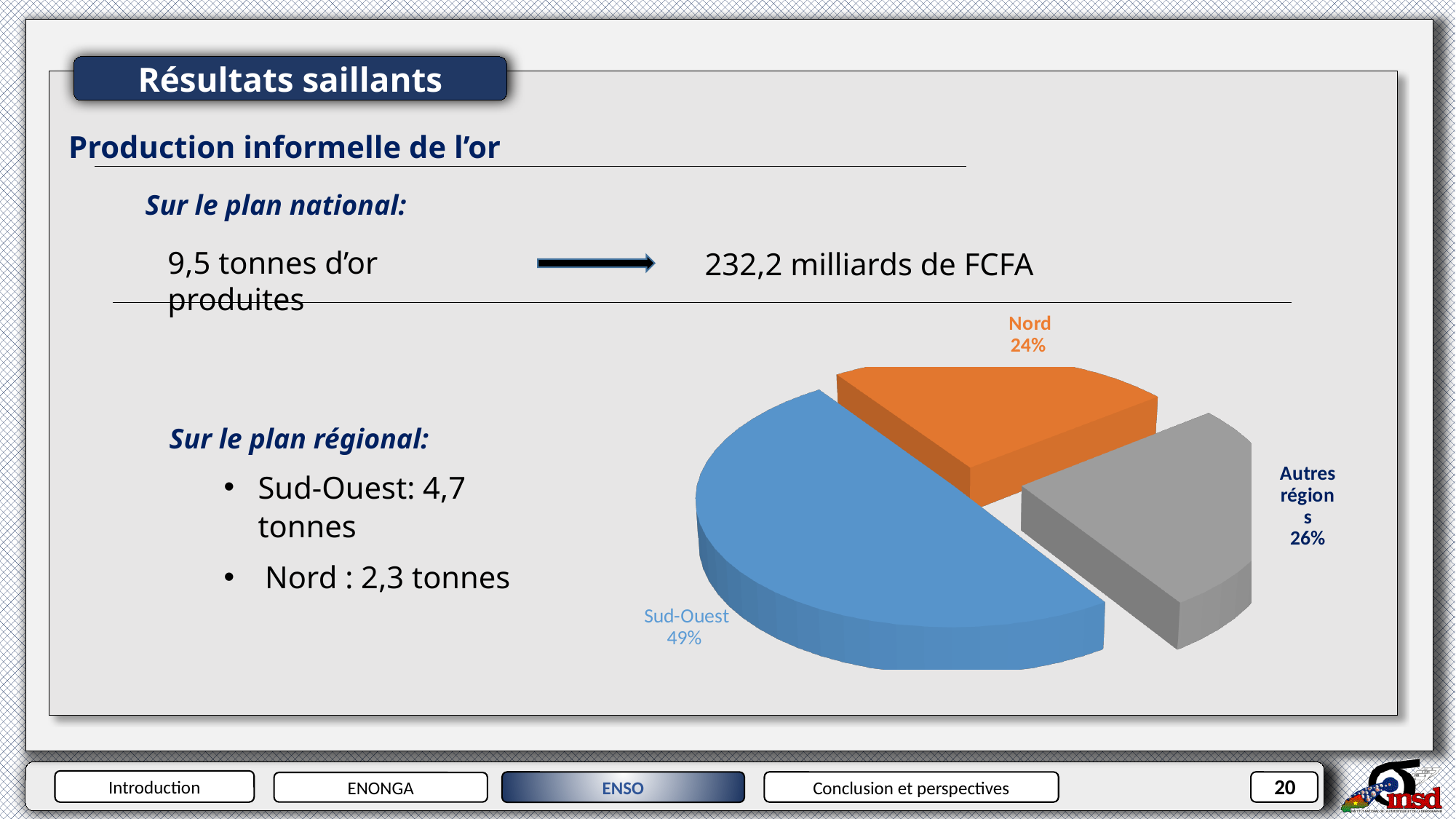
Which slice of the pie chart is the largest? Sud-Ouest What kind of chart is shown on the slide? pie chart What colour is the Sud-Ouest slice of the pie chart? blue What share of the pie does Nord represent? 24% What colour is the Nord slice of the pie chart? orange Which slice of the pie chart is the smallest? Nord Which is larger, the Sud-Ouest slice or the Autres régions slice? Sud-Ouest What share of the pie does Sud-Ouest represent? 49% What is the difference in percentage points between the Autres régions slice and the Nord slice? 2 What share of the pie does Autres régions represent? 26% How many slices does the pie chart have? 3 What is the difference in percentage points between the Sud-Ouest slice and the Nord slice? 25